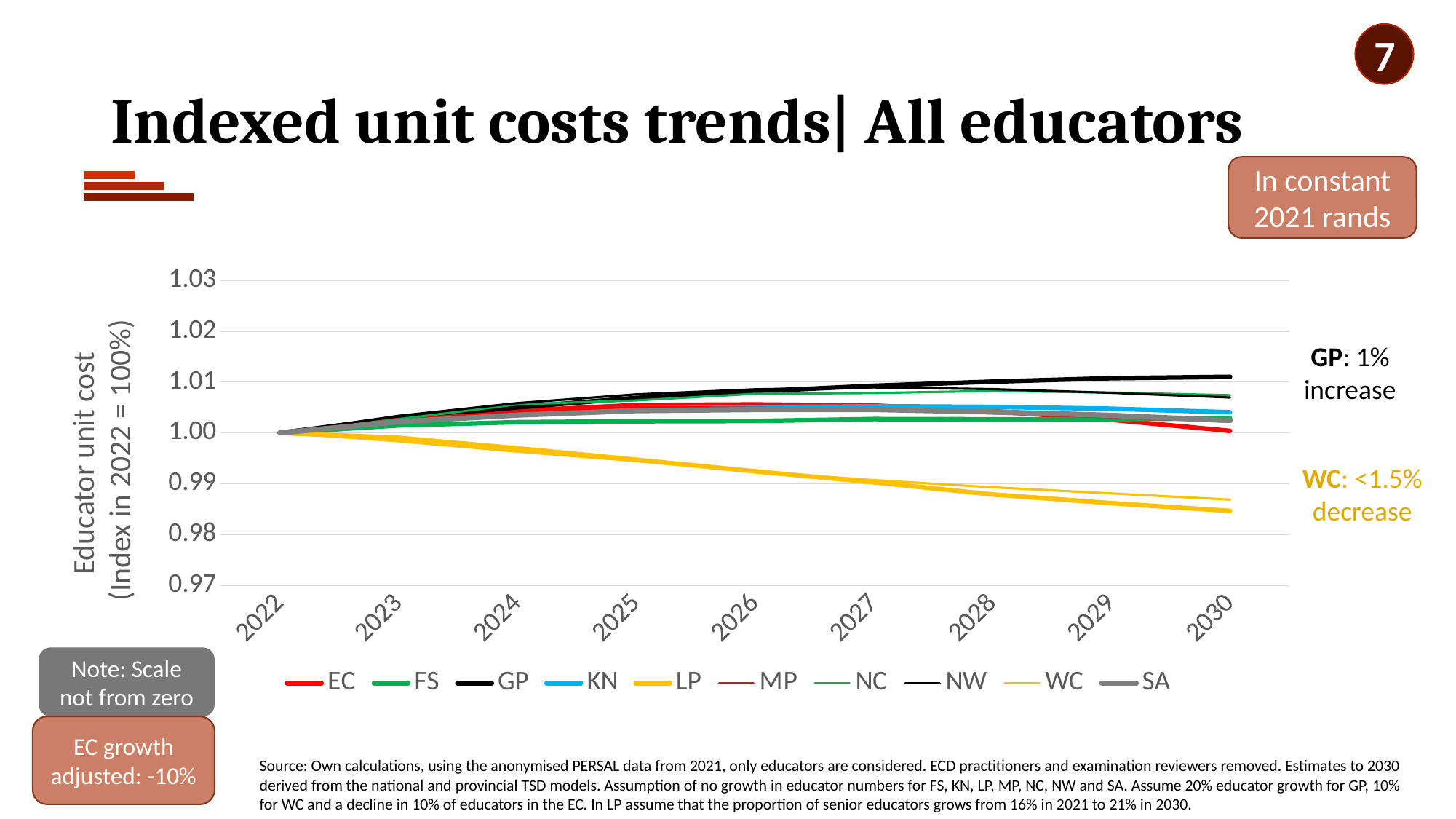
How many years are shown along the x axis? 9 What kind of chart is shown on the slide? line chart Is the value for LP in 2030 greater or less than 0.99? less Which series has the highest value in 2030? GP Is the value for WC in 2030 greater or less than 0.99? less How many series does the legend list? 10 Does the GP series rise or fall from 2022 to 2030? rise What is the value for GP in 2022? 1.00 Is the value for GP in 2030 greater or less than 1.00? greater Does the LP series rise or fall from 2022 to 2030? fall What is the y-axis title of the chart? Educator unit cost (Index in 2022 = 100%) Which is larger in 2030, the value for GP or the value for LP? GP